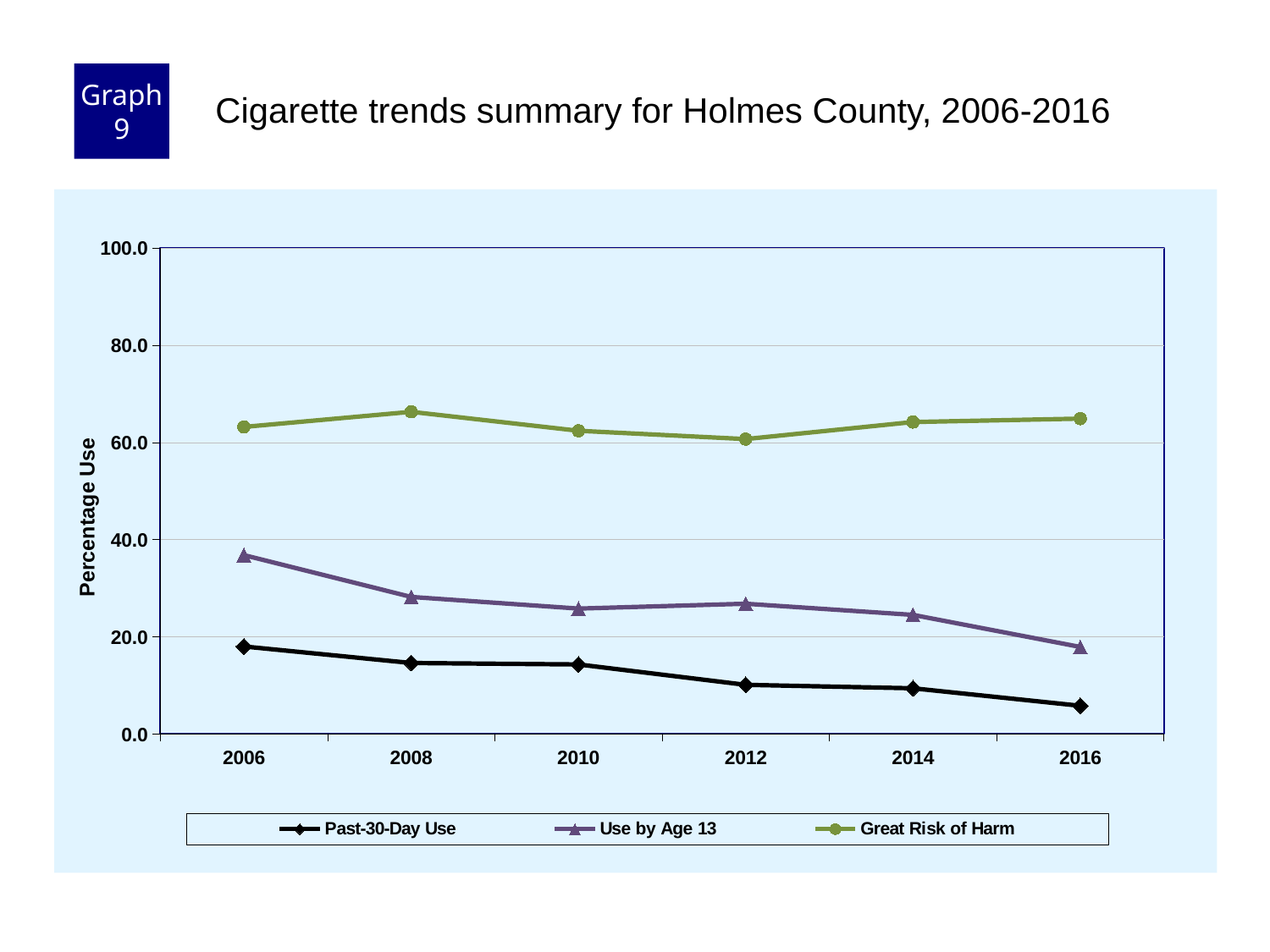
In 2006, which is larger: Use by Age 13 or Past-30-Day Use? Use by Age 13 What is the label on the y axis? Percentage Use In which year is Past-30-Day Use lowest? 2016 How many years are plotted along the x axis? 6 In which year is Use by Age 13 highest? 2006 Is the value for Past-30-Day Use in 2016 greater or less than 20? less Is the value for Use by Age 13 in 2008 greater or less than 20? greater How many series does the legend list? 3 Does the Past-30-Day Use line rise or fall from 2006 to 2016? fall What is the title of the chart? Cigarette trends summary for Holmes County, 2006-2016 What kind of chart is shown on the slide? line chart Is the value for Great Risk of Harm in 2008 greater or less than 60? greater